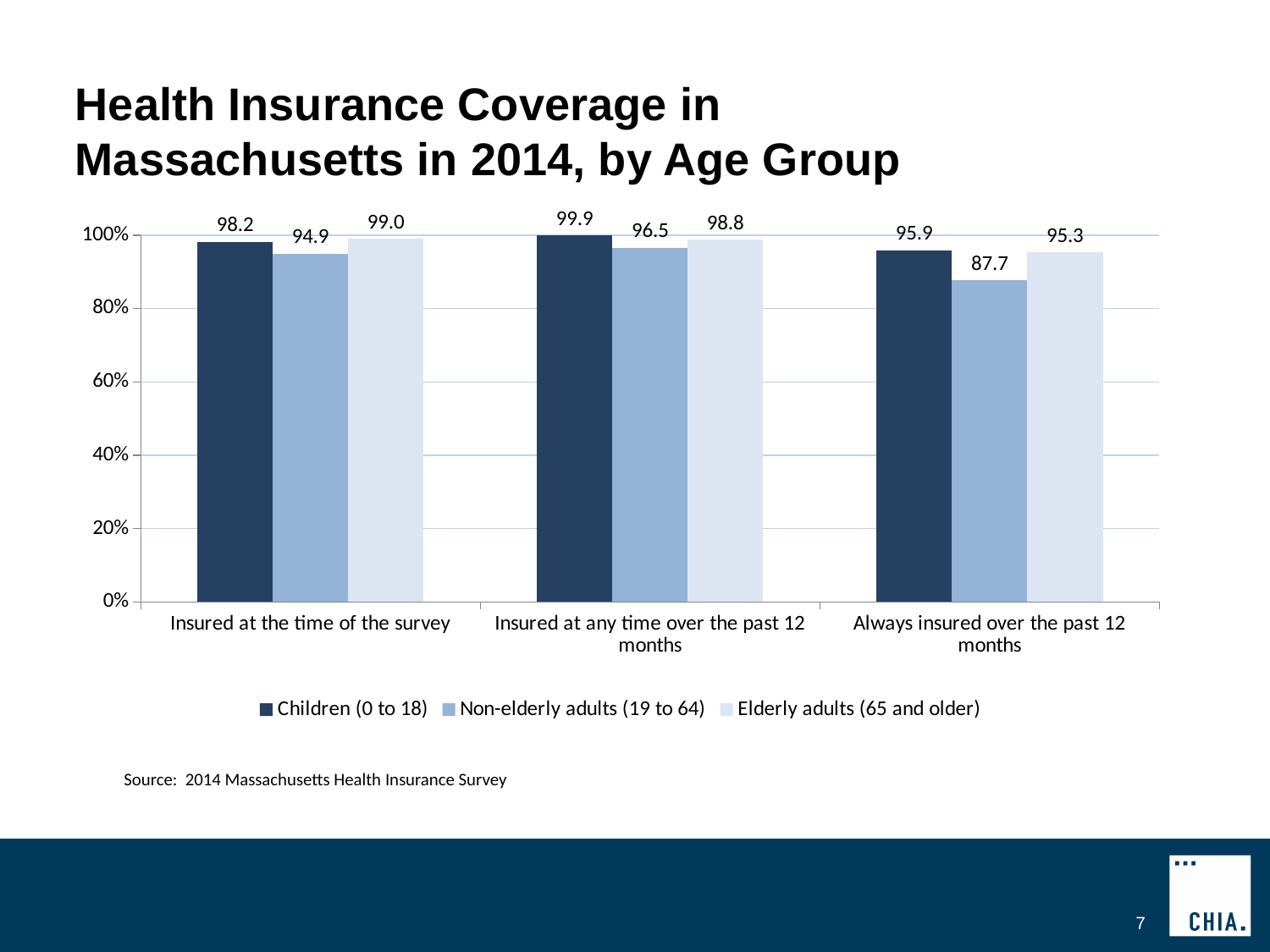
What is the value for Children (0 to 18) in the 'Insured at the time of the survey' category? 98.2 How many series does the legend list? 3 What is the value for Elderly adults (65 and older) in the 'Insured at any time over the past 12 months' category? 98.8 Which age group has the highest value in the 'Insured at any time over the past 12 months' category? Children (0 to 18) Is the value for Non-elderly adults (19 to 64) in the 'Always insured over the past 12 months' category greater or less than 80%? greater What kind of chart is shown on the slide? Bar chart Which age group has the lowest value in the 'Always insured over the past 12 months' category? Non-elderly adults (19 to 64) What is the value for Non-elderly adults (19 to 64) in the 'Always insured over the past 12 months' category? 87.7 Which is larger: the Non-elderly adults (19 to 64) value for 'Insured at the time of the survey' or for 'Insured at any time over the past 12 months'? Insured at any time over the past 12 months What is the source cited below the chart? 2014 Massachusetts Health Insurance Survey How many categories are shown on the x axis? 3 What is the difference between the Children (0 to 18) value and the Non-elderly adults (19 to 64) value in the 'Always insured over the past 12 months' category? 8.2